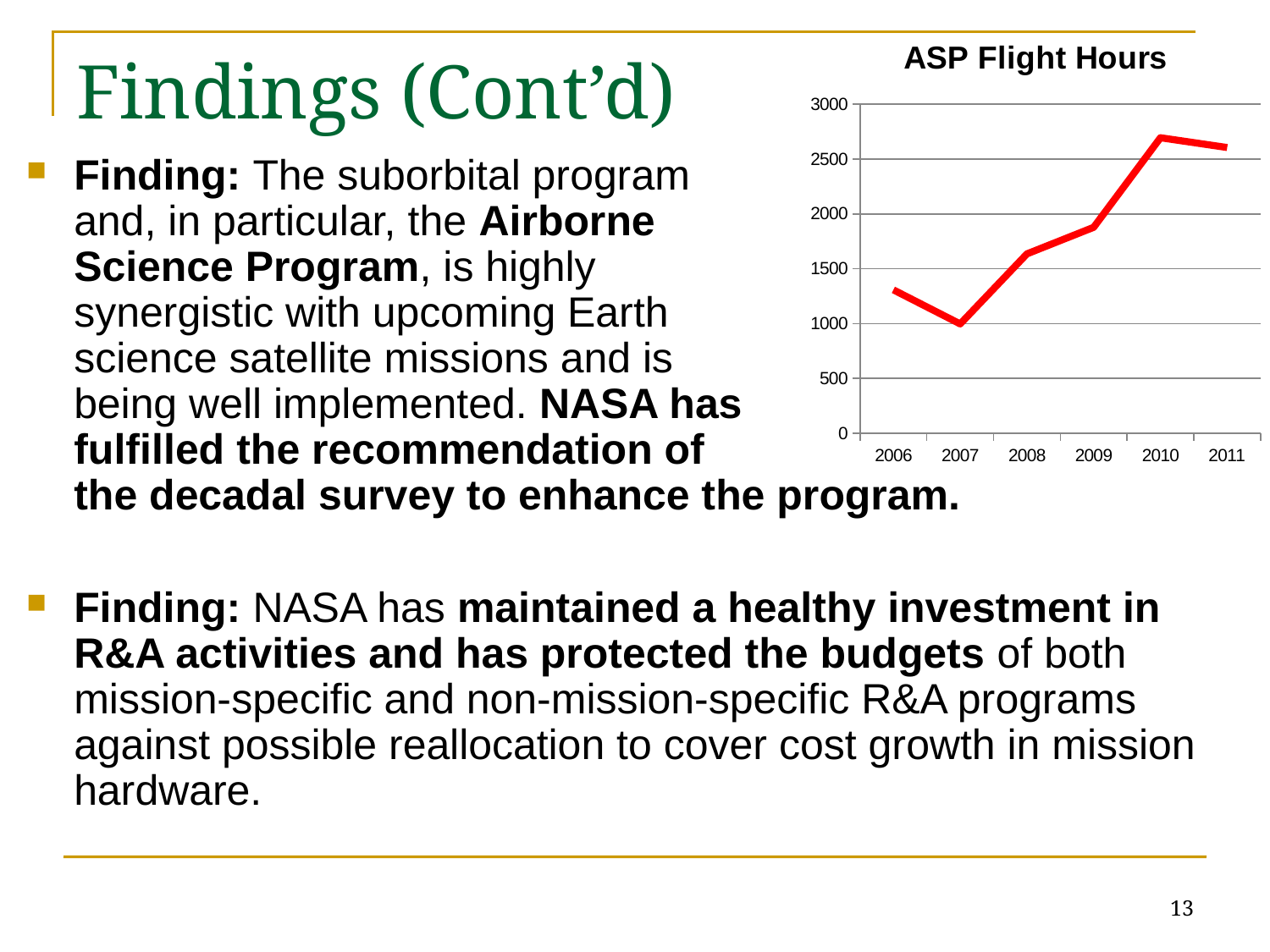
What kind of chart is shown on the slide? line chart Is the value for 2008 greater or less than 1500? greater What is the title of the chart? ASP Flight Hours Is the value for 2007 greater or less than 1500? less In which year are ASP flight hours lowest? 2007 Which year has more ASP flight hours, 2006 or 2008? 2008 Is the value for 2006 greater or less than 1000? greater How many years are plotted on the x axis of the ASP Flight Hours chart? 6 Which year has more ASP flight hours, 2009 or 2010? 2010 In which year are ASP flight hours highest? 2010 Do ASP flight hours generally rise or fall from 2006 to 2011? rise